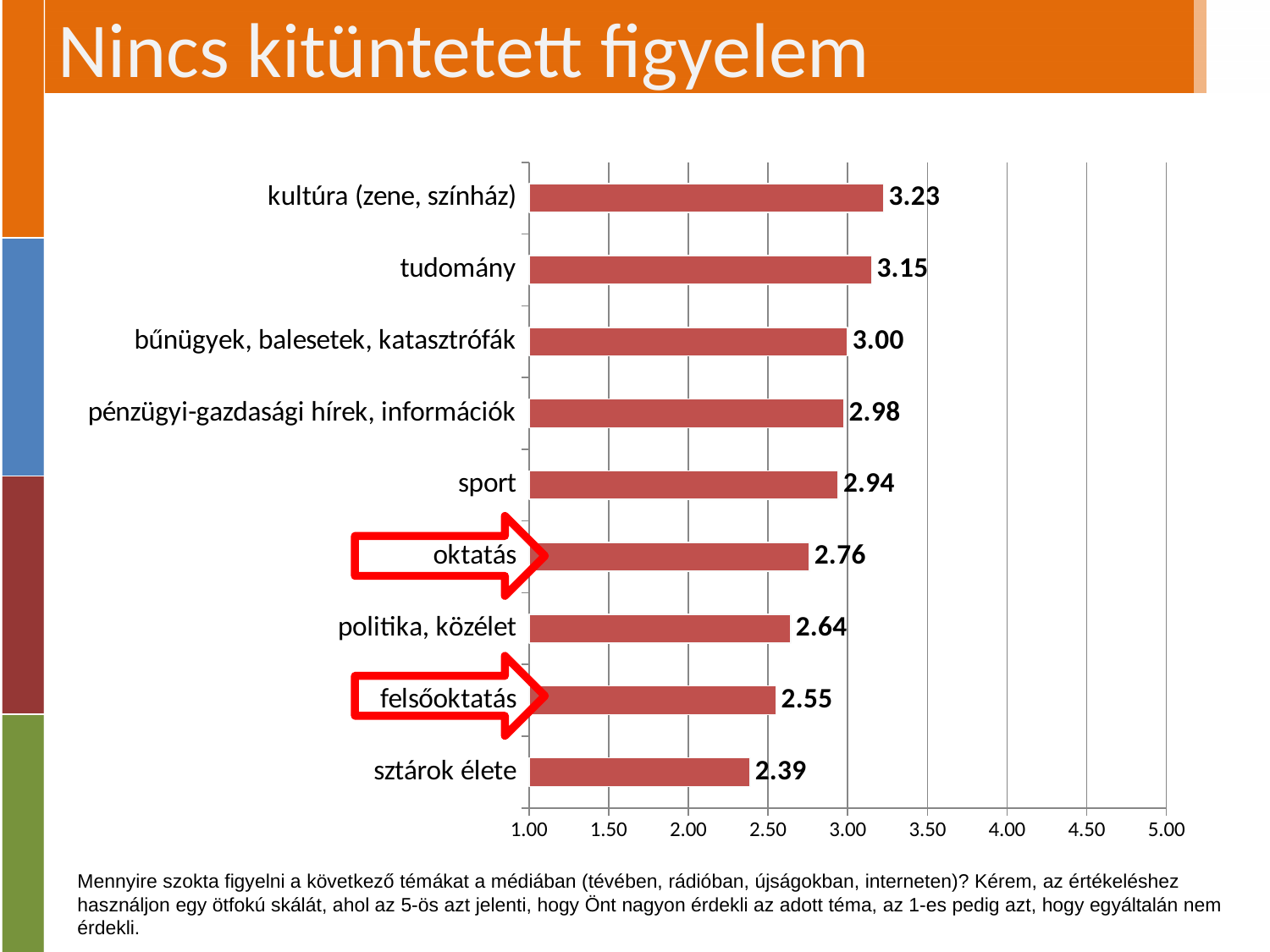
How many categories are shown in the chart? 9 Which category has the highest value? kultúra (zene, színház) What is the value for sport? 2.94 What is the value for oktatás? 2.76 Which has a larger value, bűnügyek, balesetek, katasztrófák or sztárok élete? bűnügyek, balesetek, katasztrófák What is the value for kultúra (zene, színház)? 3.23 Which category has the lowest value? sztárok élete What is the difference between the values for tudomány and politika, közélet? 0.51 What is the difference between the values for oktatás and felsőoktatás? 0.21 What is the value for felsőoktatás? 2.55 What is the maximum value shown on the horizontal axis? 5.00 What kind of chart is shown on the slide? bar chart